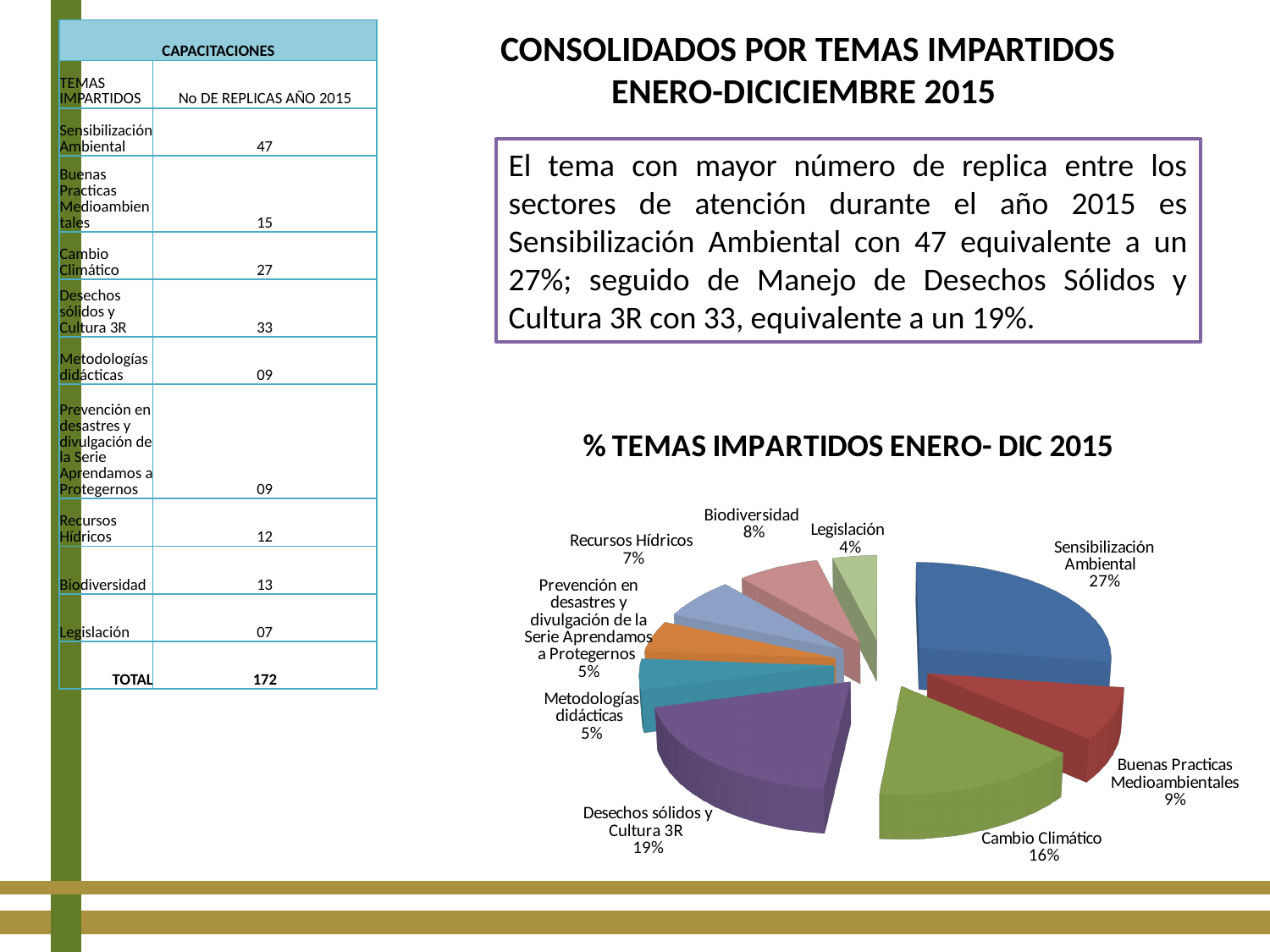
What percentage is shown for Cambio Climático in the pie chart? 16% What is the difference in percentage points between Sensibilización Ambiental and Desechos sólidos y Cultura 3R in the pie chart? 8 Which category has the largest slice of the pie chart? Sensibilización Ambiental What kind of chart is shown on the slide? Pie chart What share of the pie does Sensibilización Ambiental represent? 27% Which category has the smallest slice of the pie chart? Legislación Which is larger in the pie chart, Recursos Hídricos or Buenas Practicas Medioambientales? Buenas Practicas Medioambientales How many slices does the pie chart have? 9 What percentage is shown for Desechos sólidos y Cultura 3R in the pie chart? 19% What is the title of the pie chart? % TEMAS IMPARTIDOS ENERO- DIC 2015 What percentage is shown for Metodologías didácticas in the pie chart? 5% What percentage is shown for Biodiversidad in the pie chart? 8%